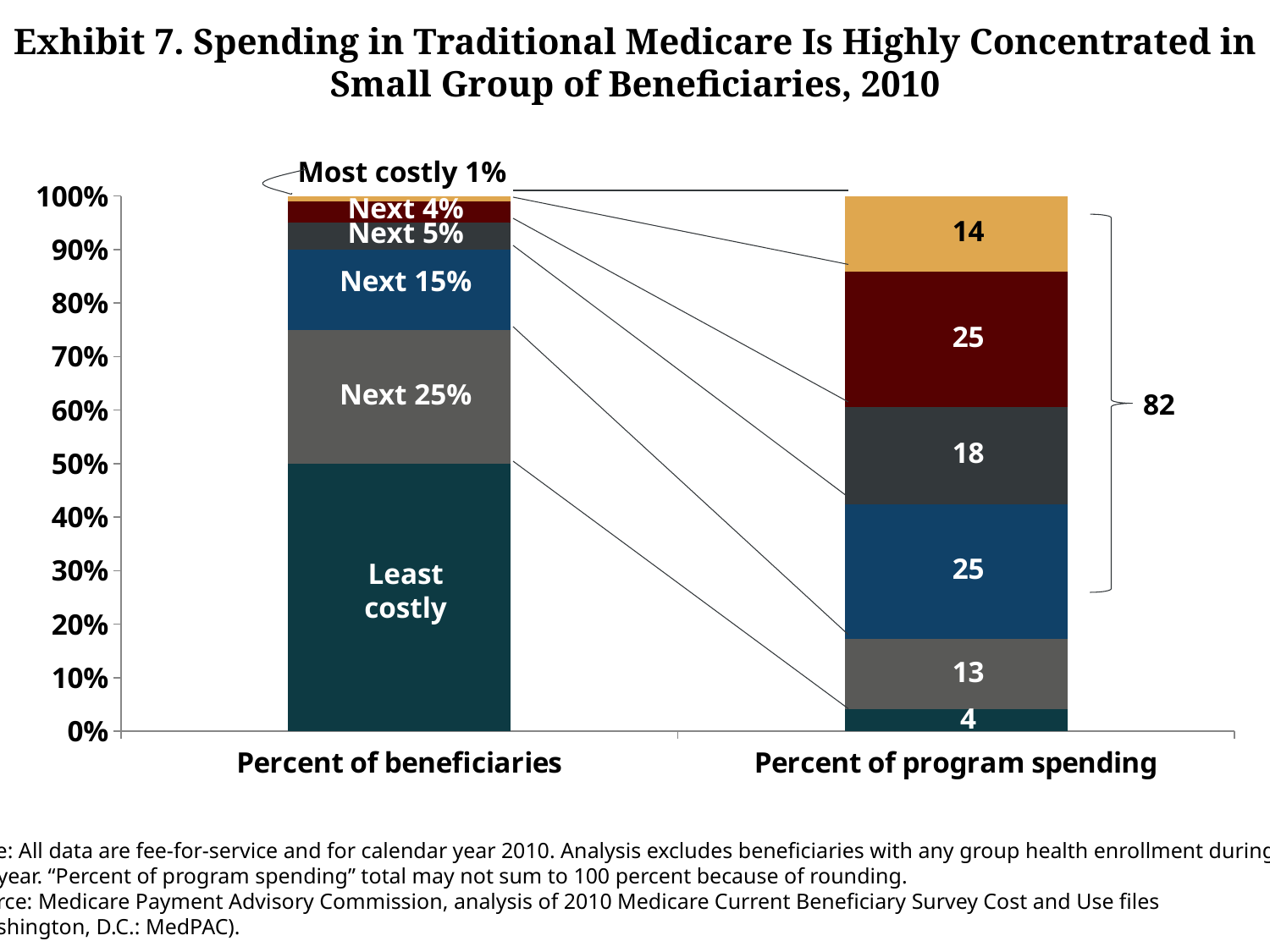
What percent of program spending is attributed to the Least costly group? 4 Which beneficiary group accounts for the smallest share of program spending? Least costly What percent of program spending is attributed to the Most costly 1% of beneficiaries? 14 What kind of chart is shown on the slide? Stacked bar chart Which group has a larger share of program spending: Next 5% or Next 25%? Next 5% What is the difference in program spending share between the Next 5% group (18) and the Least costly group (4)? 14 How many beneficiary groups are stacked in each bar? 6 How many bars are shown on the x axis of the chart? 2 What percent of program spending is attributed to the Next 4% group? 25 What are the two category labels on the x axis of the chart? Percent of beneficiaries; Percent of program spending What percent of program spending is attributed to the Next 5% group? 18 What is the combined share of program spending for the top four groups (Most costly 1%, Next 4%, Next 5%, Next 15%), as shown by the bracket? 82